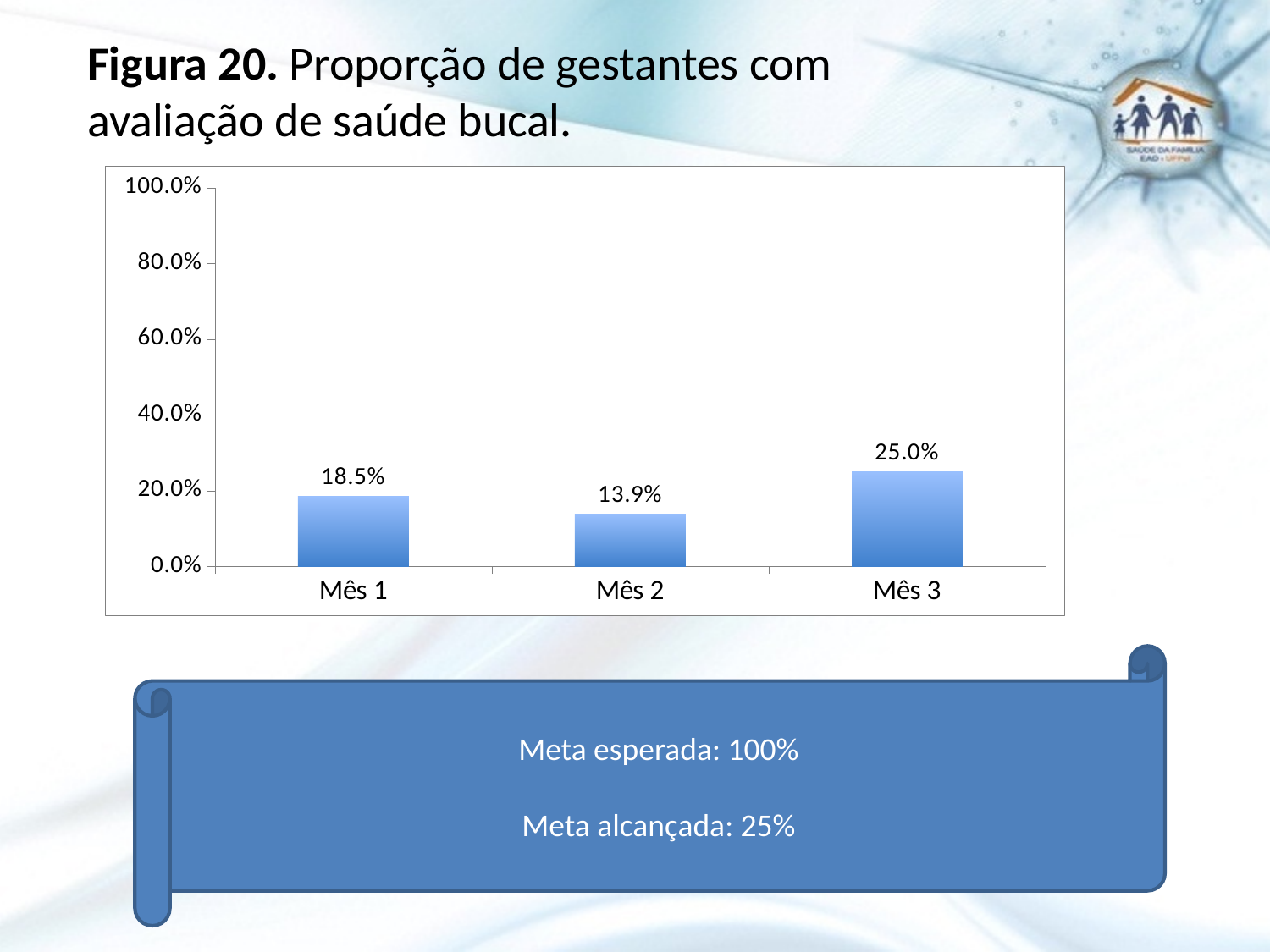
Which is larger, the value for Mês 1 or the value for Mês 2? Mês 1 What is the value for Mês 2? 13.9% What is the difference between the values for Mês 3 and Mês 1? 6.5% Which month has the lowest value? Mês 2 What is the value for Mês 3? 25.0% What is the maximum value shown on the y axis? 100.0% How many months are shown on the x axis? 3 What is the value for Mês 1? 18.5% Which month has the highest value? Mês 3 What kind of chart is shown on the slide? bar chart What is the difference between the values for Mês 1 and Mês 2? 4.6% Is the value for Mês 3 greater or less than 20.0%? greater